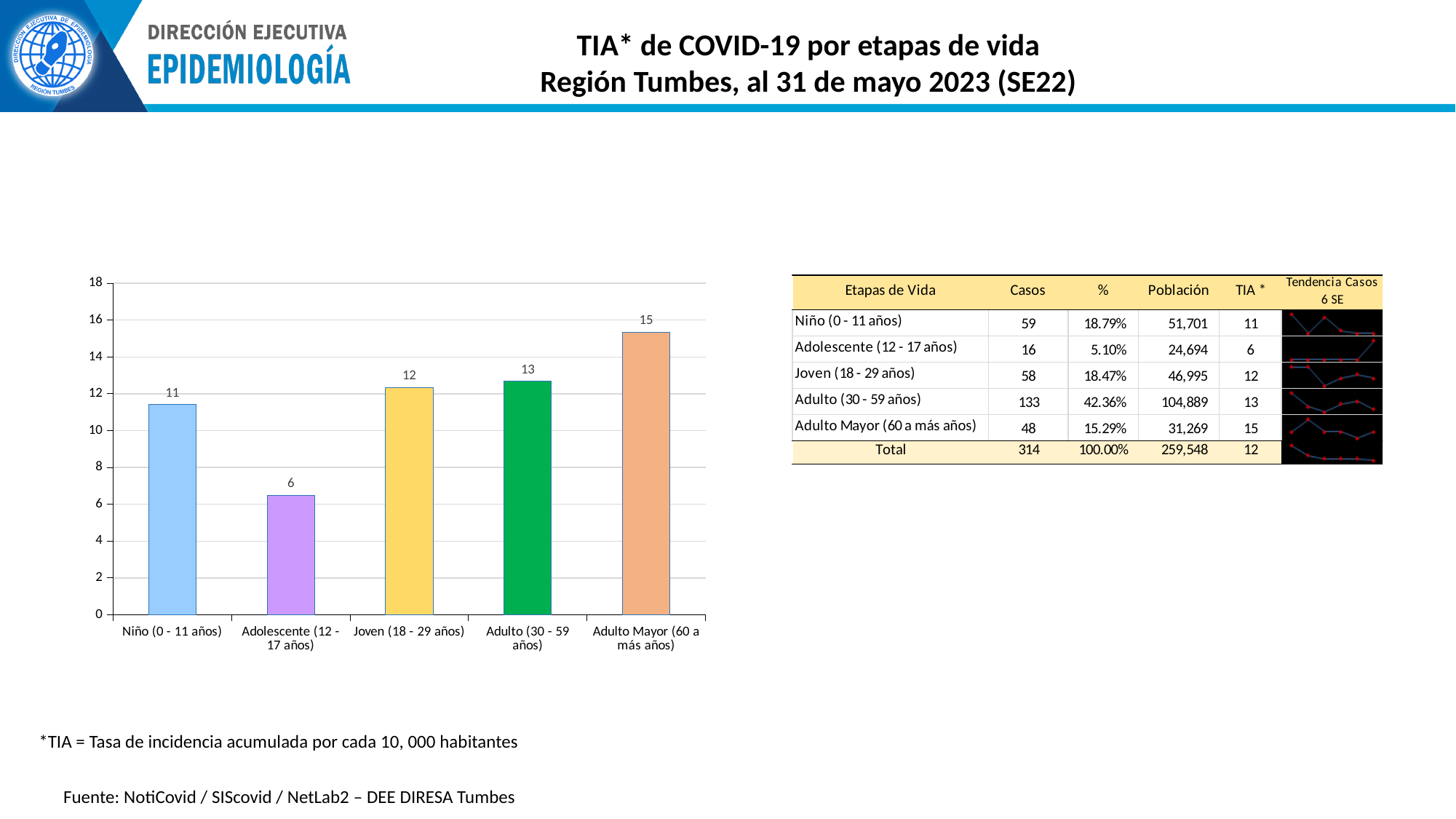
What is the TIA value shown for Adolescente (12 - 17 años) in the bar chart? 6 What type of chart is shown on the slide? bar chart Is the bar for Adulto Mayor (60 a más años) greater or less than 14 on the y axis? greater What is the TIA value shown for Adulto Mayor (60 a más años) in the bar chart? 15 Which etapa de vida has the lowest TIA in the bar chart? Adolescente (12 - 17 años) Which has a higher TIA in the bar chart, Adulto (30 - 59 años) or Niño (0 - 11 años)? Adulto (30 - 59 años) How many categories (etapas de vida) are plotted in the bar chart? 5 What is the maximum value shown on the y axis of the bar chart? 18 What is the TIA value shown for Joven (18 - 29 años) in the bar chart? 12 What is the difference between the TIA labels for Adulto Mayor (60 a más años) and Adolescente (12 - 17 años)? 9 Which etapa de vida has the highest TIA in the bar chart? Adulto Mayor (60 a más años) What is the TIA value shown for Niño (0 - 11 años) in the bar chart? 11